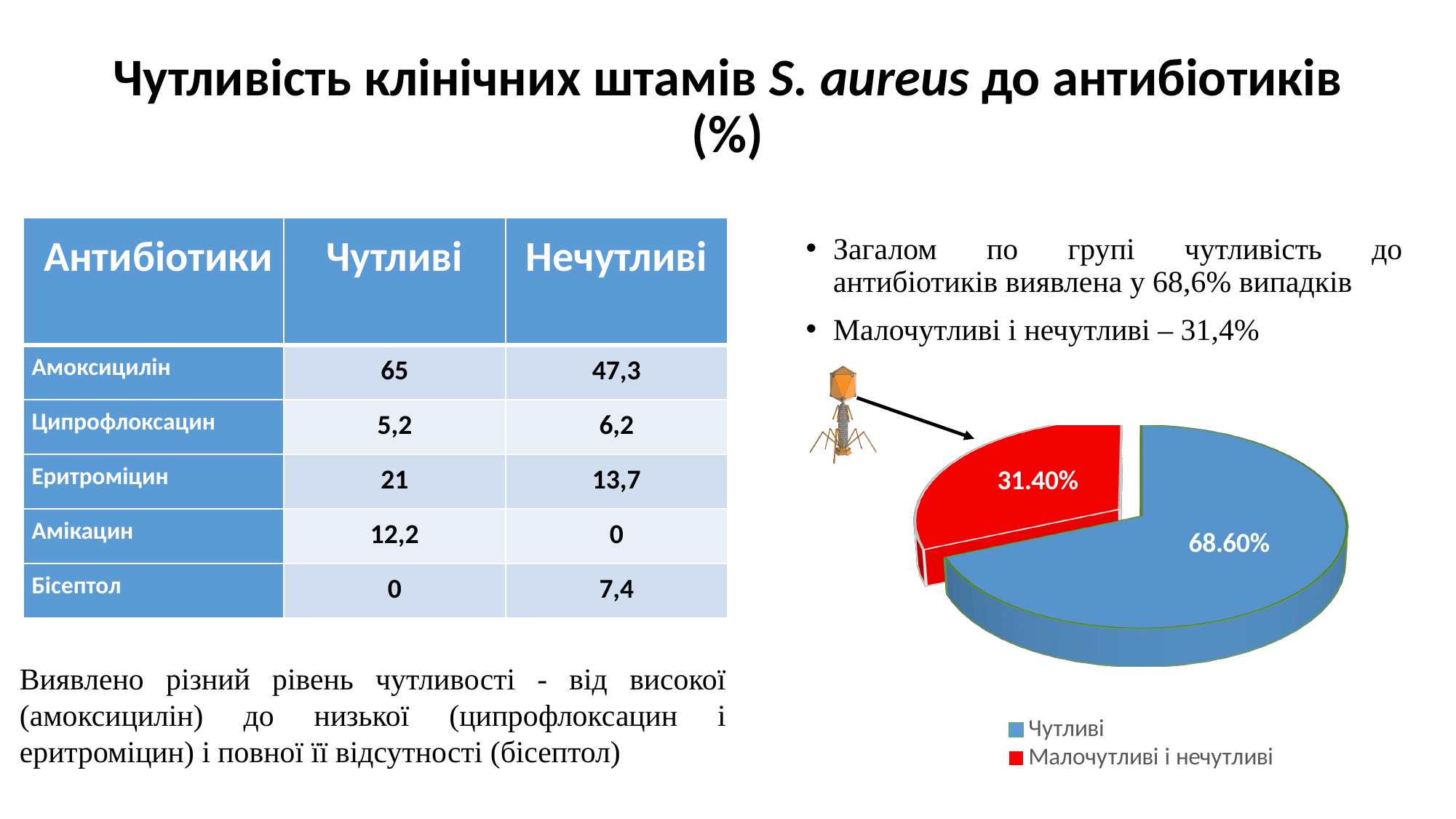
What colour is the "Чутливі" slice in the pie chart? blue Which slice of the pie chart is the largest? Чутливі Which slice of the pie chart is the smallest? Малочутливі і нечутливі What is the difference between the "Чутливі" and "Малочутливі і нечутливі" slices of the pie chart? 37.20% What colour is the "Малочутливі і нечутливі" slice in the pie chart? red Is the "Чутливі" slice of the pie chart greater or less than 50%? greater What share of the pie chart is labelled "Чутливі"? 68.60% What kind of chart is shown on the right side of the slide? pie chart Which is larger in the pie chart: "Чутливі" or "Малочутливі і нечутливі"? Чутливі How many entries does the pie chart legend list? 2 What share of the pie chart is labelled "Малочутливі і нечутливі"? 31.40% How many slices does the pie chart have? 2